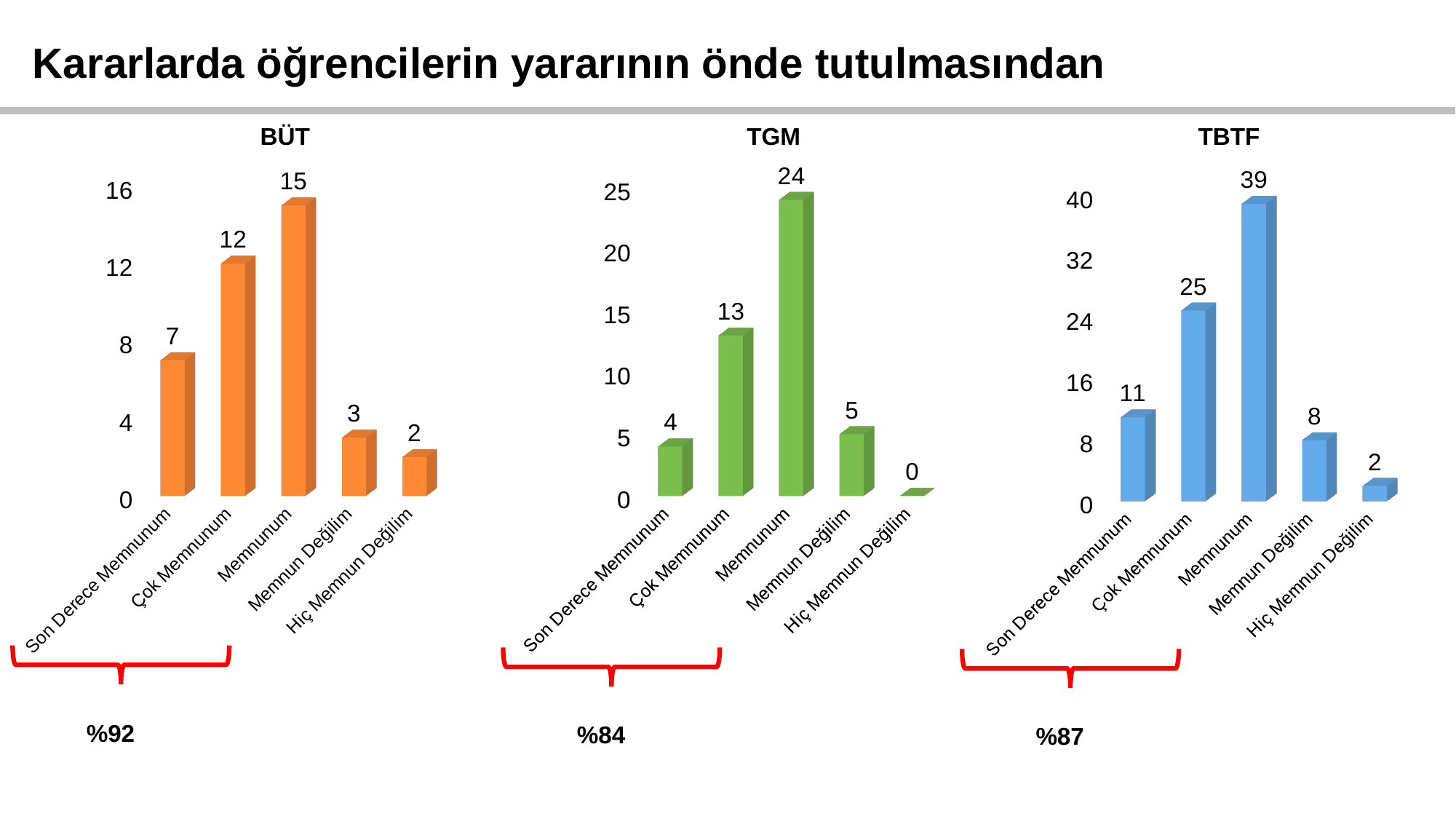
In the BÜT chart, what is the value for Memnunum? 15 How many categories are shown in the TGM chart? 5 In the TBTF chart, what is the value for Çok Memnunum? 25 How many charts are on the slide? 3 What colour are the bars in the TGM chart? green In the TBTF chart, which category has the highest value? Memnunum In the BÜT chart, which category has the lowest value? Hiç Memnun Değilim What kind of chart is the BÜT chart? bar chart In the TGM chart, what is the difference between Memnunum and Çok Memnunum? 11 In the TBTF chart, which is larger: Son Derece Memnunum or Memnun Değilim? Son Derece Memnunum In the TGM chart, what is the value for Hiç Memnun Değilim? 0 In the BÜT chart, what is the difference between Çok Memnunum and Son Derece Memnunum? 5